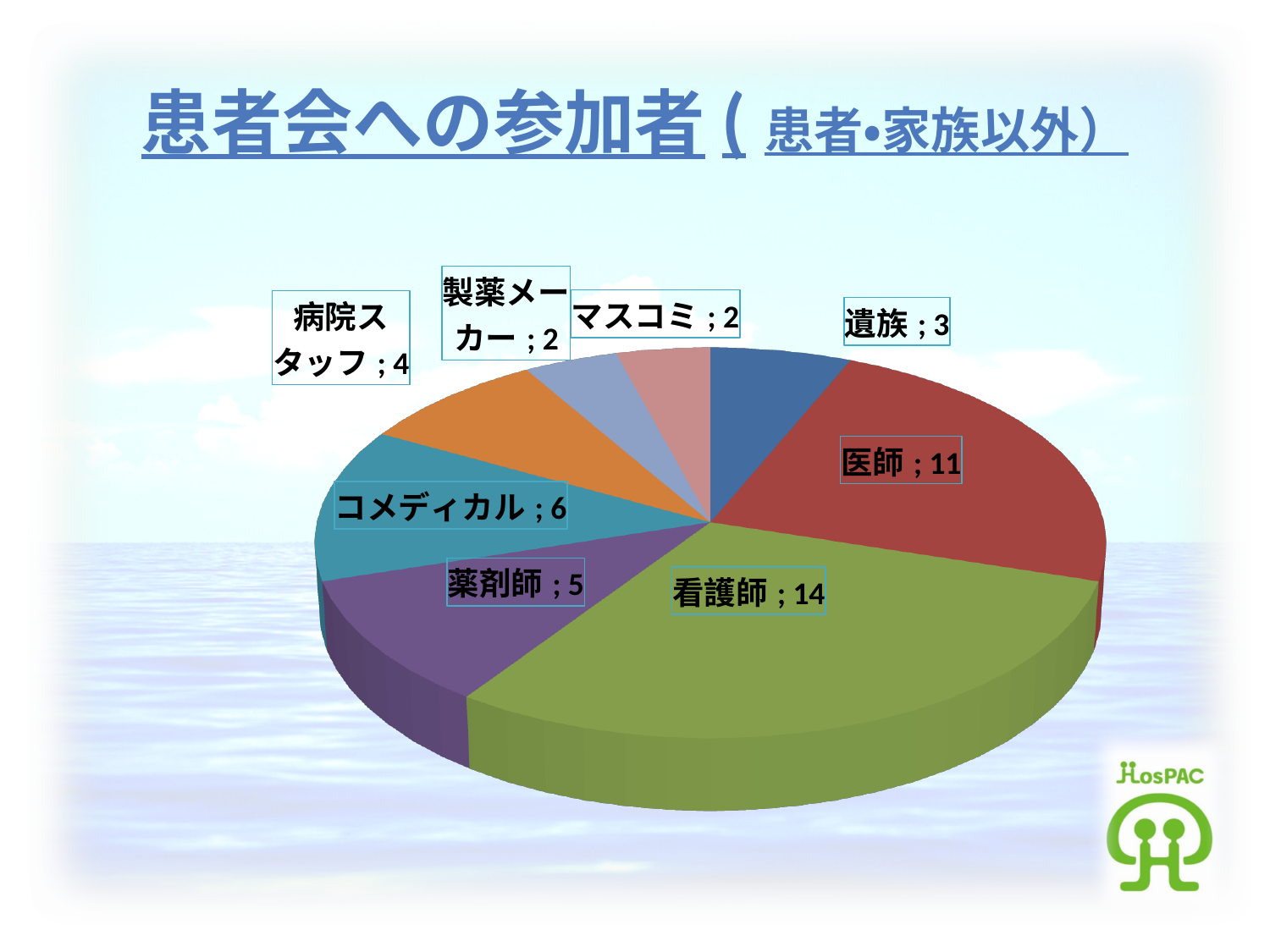
Which category has the largest slice in the pie chart? 看護師 What is the value for 医師 in the pie chart? 11 Which is larger, the value for 薬剤師 or the value for 遺族? 薬剤師 What kind of chart is shown on the slide? Pie chart What is the value for コメディカル in the pie chart? 6 How many categories are shown in the pie chart? 8 What is the value for 遺族 in the pie chart? 3 What is the difference between the values for 看護師 and 医師? 3 What is the value for 看護師 in the pie chart? 14 What is the total of all the values shown in the pie chart? 47 Which categories share the smallest value in the pie chart? 製薬メーカー and マスコミ What is the difference between the values for コメディカル and 病院スタッフ? 2